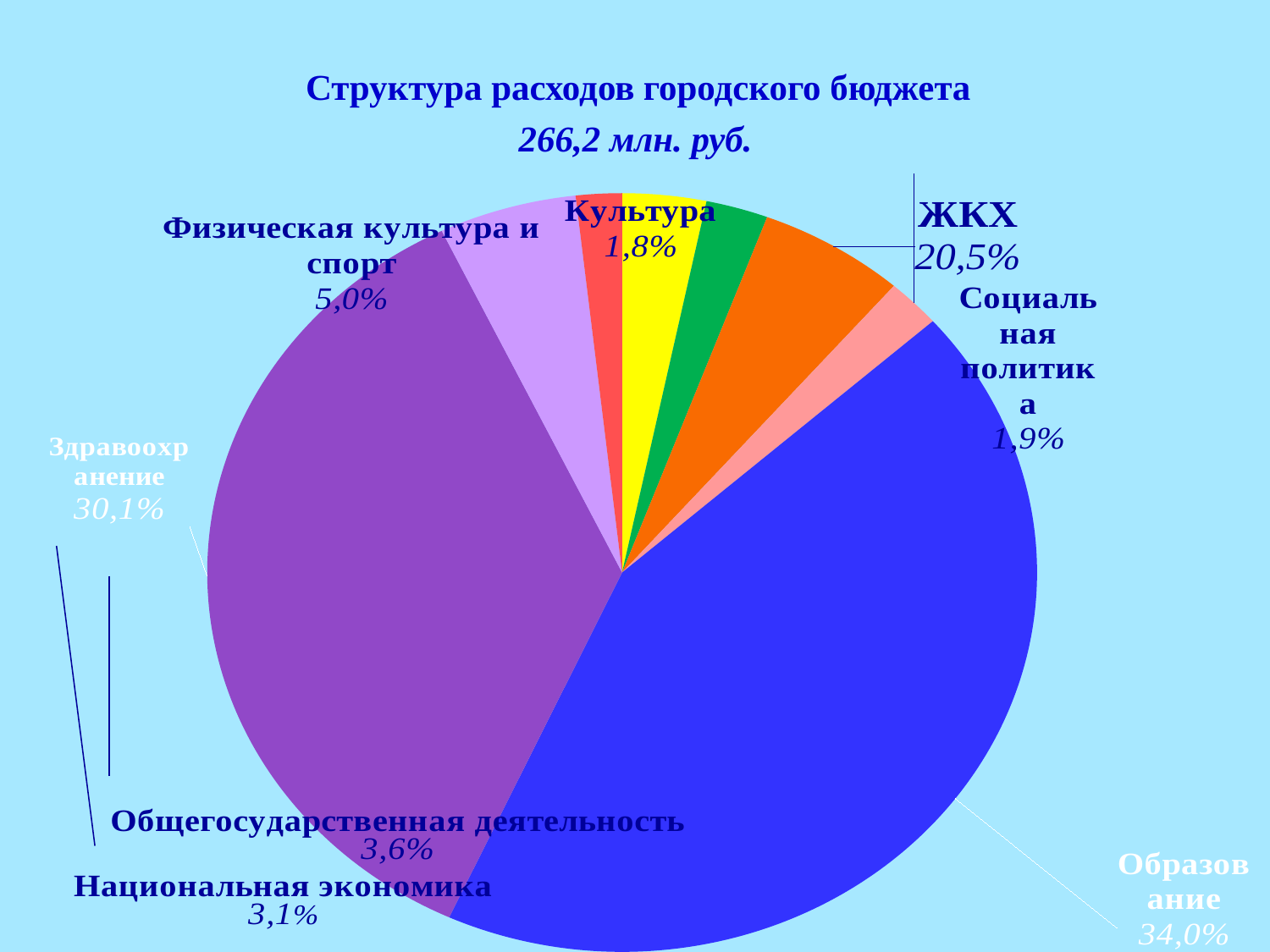
Which category has the smallest share of the budget expenditure? Культура What is the title of the chart? Структура расходов городского бюджета 266,2 млн. руб. What percentage is shown for ЖКХ? 20,5% Which is larger, the share for Общегосударственная деятельность or for Национальная экономика? Общегосударственная деятельность What kind of chart is shown on the slide? Pie chart Which category has the largest share of the budget expenditure? Образование What percentage is shown for Физическая культура и спорт? 5,0% What share of the city budget expenditure goes to Образование? 34,0% How many categories (slices) does the pie chart show? 8 What is the difference in percentage points between Образование and Здравоохранение? 3,9 What percentage is shown for Культура? 1,8% What share of expenditure is labelled for Здравоохранение? 30,1%